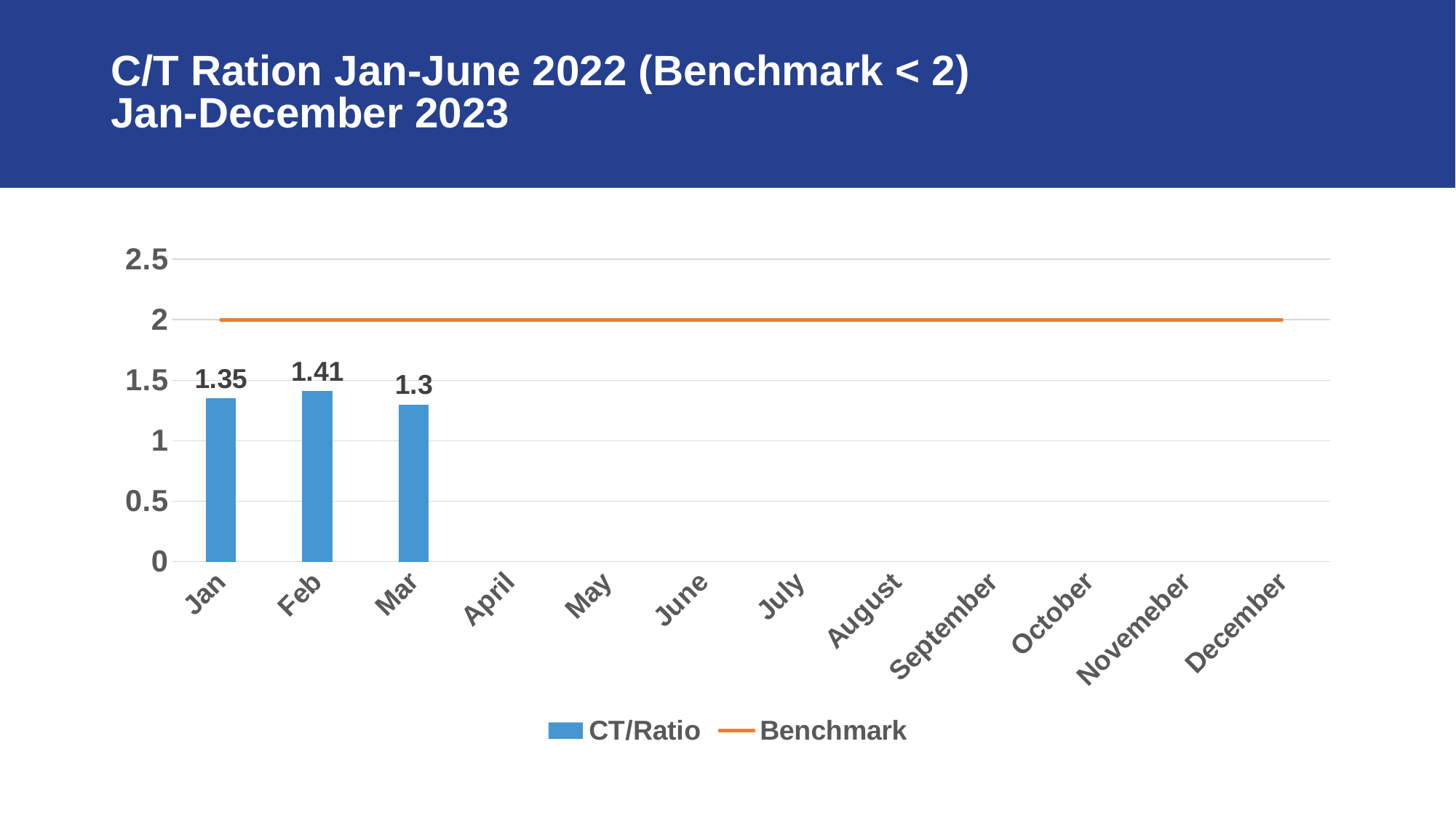
How many series does the legend list? 2 How many month categories are shown on the x axis? 12 Which month has the lowest CT/Ratio value among the plotted bars? Mar What colour is the Benchmark line in the legend? Orange What kind of chart is used to show the CT/Ratio values? Bar chart Which month has the highest CT/Ratio value? Feb What is the CT/Ratio value for Feb? 1.41 Which is larger, the CT/Ratio value for Jan or for Mar? Jan What is the difference between the CT/Ratio values for Feb and Mar? 0.11 What is the CT/Ratio value for Jan? 1.35 What is the CT/Ratio value for Mar? 1.3 Is the Benchmark line greater or less than 1.5? greater